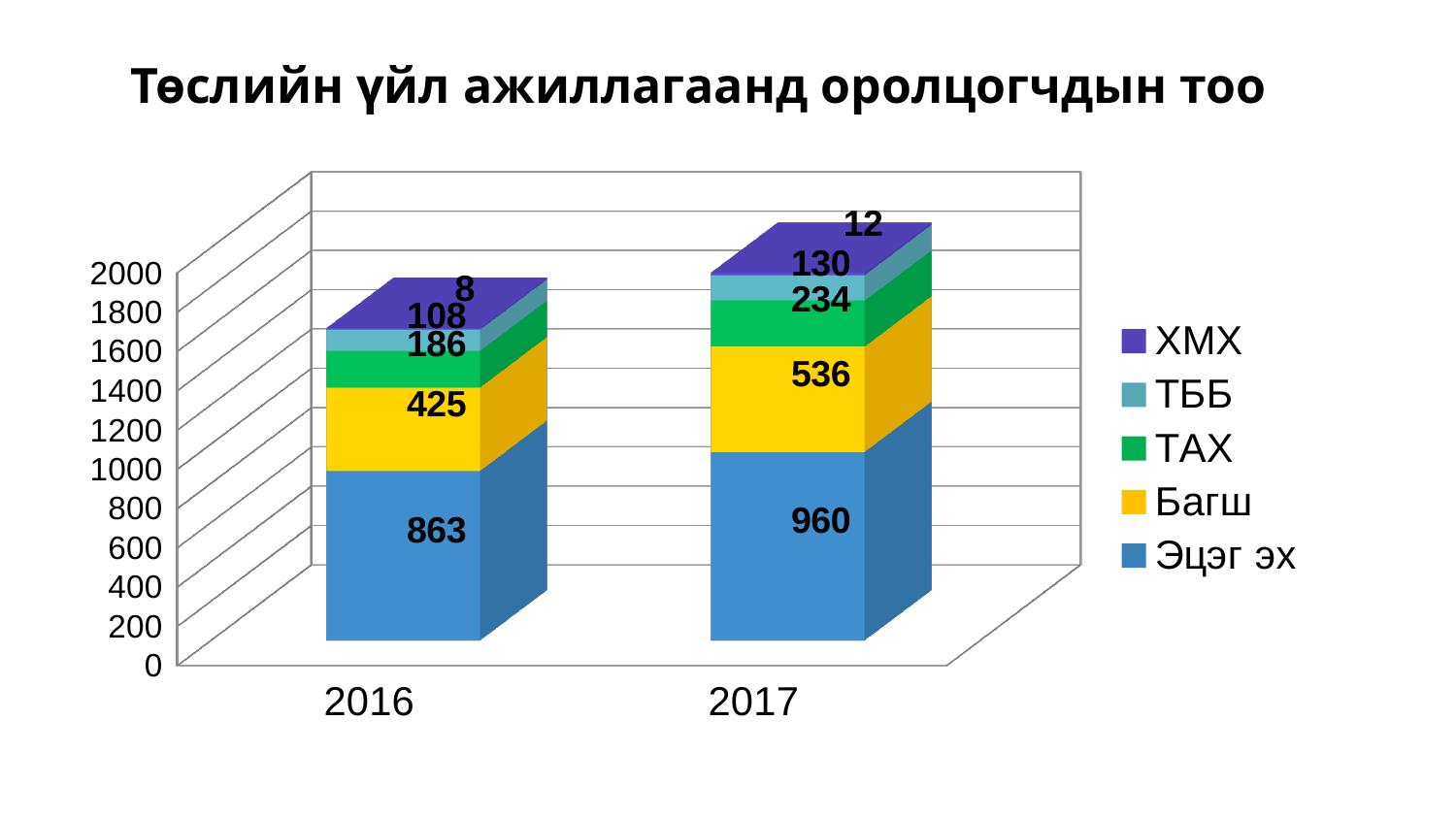
What is the value for Эцэг эх in 2016? 863 What is the total of the stacked bar for 2017? 1872 What is the value for Багш in 2017? 536 How many series does the legend list? 5 What type of chart is shown on the slide? Stacked bar chart How many categories are shown on the x axis? 2 What is the difference between the Эцэг эх values for 2017 and 2016? 97 Which is larger, the ТББ value for 2016 or for 2017? 2017 What is the value for ТАХ in 2016? 186 What is the title of the chart? Төслийн үйл ажиллагаанд оролцогчдын тоо Which series has the smallest value in 2016? ХМХ What is the value for ХМХ in 2017? 12